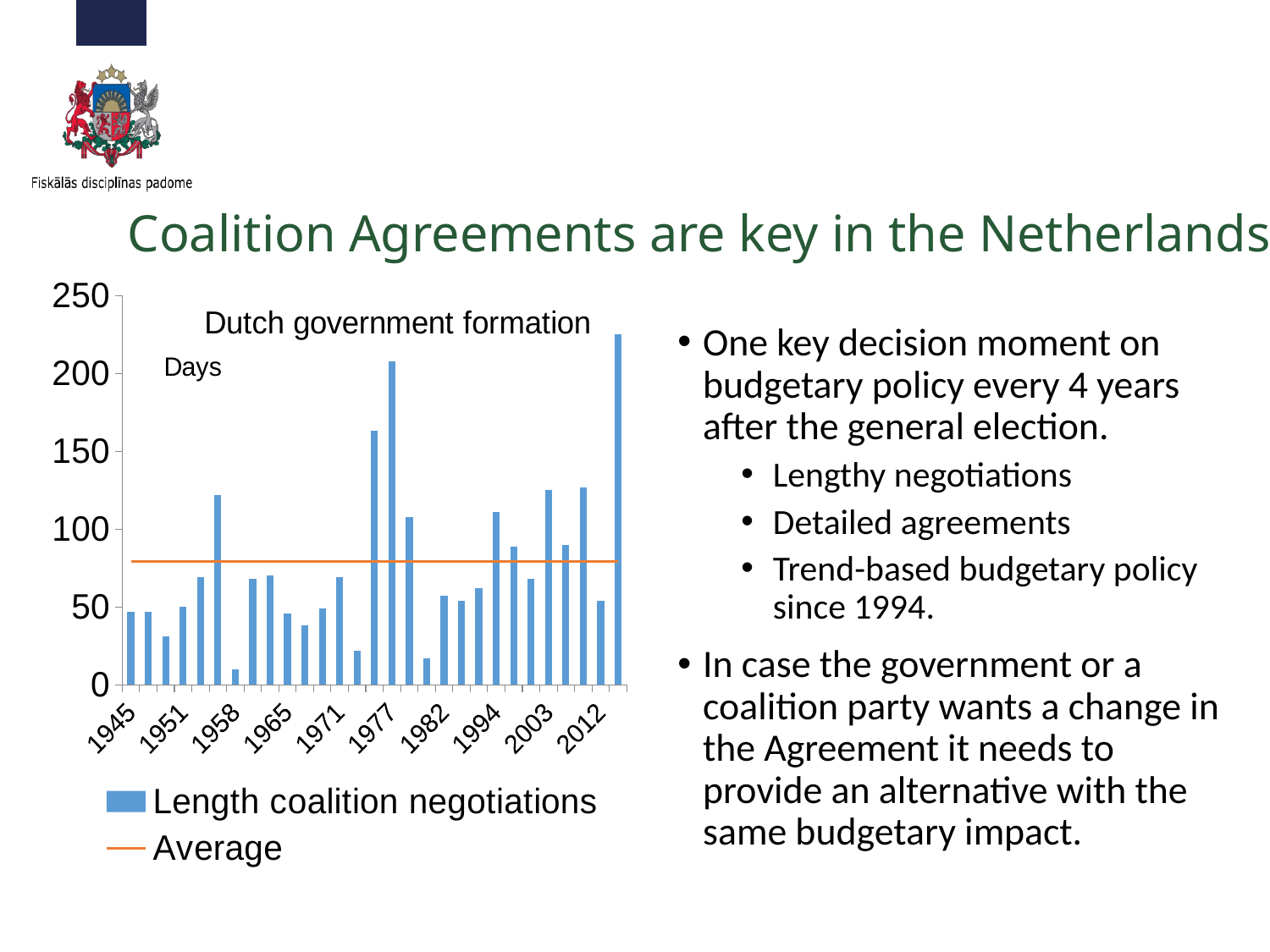
Is the tallest bar in the chart greater or less than 200? greater Which has the larger value, 1958 or 1965? 1965 What are the two entries in the chart legend? Length coalition negotiations; Average What kind of chart is shown on the slide? Combination bar and line chart (bars with an average line) Is the value for 1977 greater or less than 150? greater What is the title of the chart? Dutch government formation Is the value for 1958 greater or less than 100? less How many series does the chart legend list? 2 Which has the larger value, 1977 or 1982? 1977